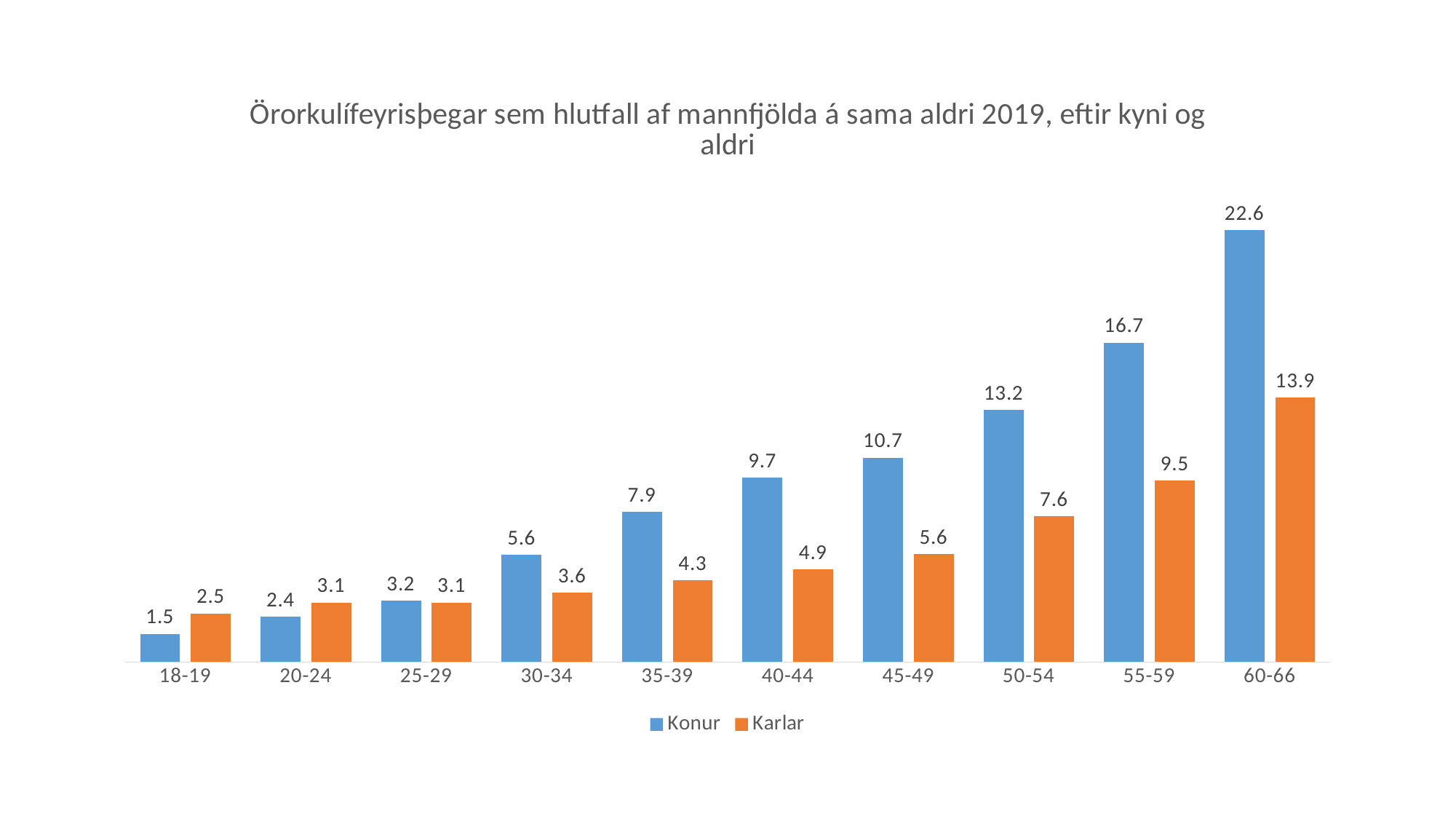
What kind of chart is shown on the slide? Bar chart What is the difference between the Konur values for 55-59 and 50-54? 3.5 How many series does the legend list? 2 Do the Konur values rise or fall as age increases along the x axis? Rise Which is larger in the 18-19 age group, Konur or Karlar? Karlar How many age groups are shown on the x axis? 10 Which age group has the highest value for Konur? 60-66 What is the value for Konur in the 40-44 age group? 9.7 Which age group has the lowest value for Karlar? 18-19 What is the value for Karlar in the 55-59 age group? 9.5 Which colour represents Karlar in the chart? Orange What is the difference between the Konur and Karlar values in the 60-66 age group? 8.7